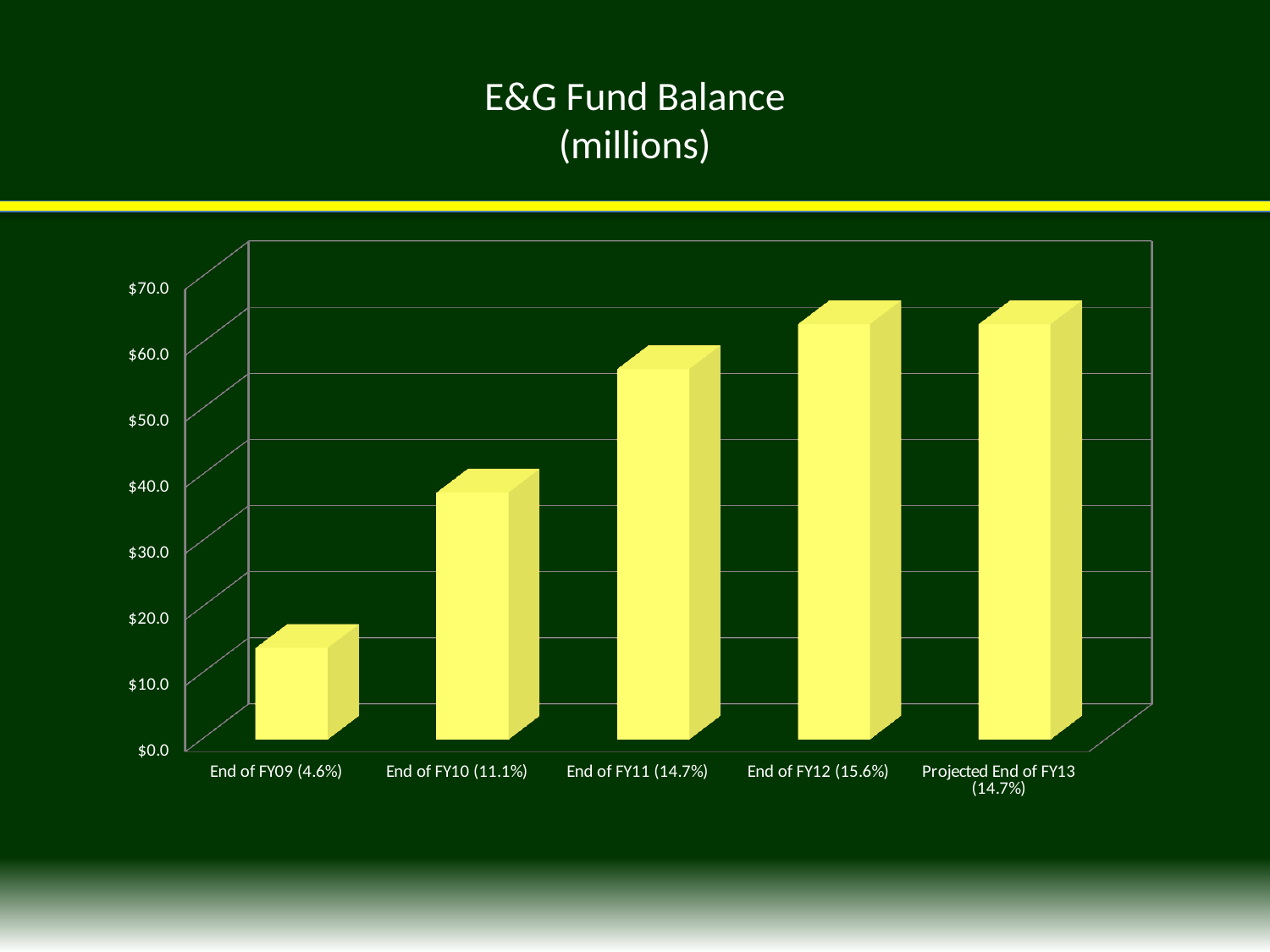
Is the value for End of FY12 (15.6%) greater or less than $60.0? greater Is the value for End of FY09 (4.6%) greater or less than $20.0? less Do the values generally rise or fall from End of FY09 to Projected End of FY13? rise Which is larger, the value for End of FY10 (11.1%) or End of FY11 (14.7%)? End of FY11 (14.7%) Is the value for End of FY10 (11.1%) greater or less than $30.0? greater What kind of chart is shown on the slide? bar chart Which category has the lowest fund balance? End of FY09 (4.6%) Which is larger, the value for End of FY09 (4.6%) or End of FY12 (15.6%)? End of FY12 (15.6%) How many categories are plotted on the x axis? 5 What is the title of the chart? E&G Fund Balance (millions)